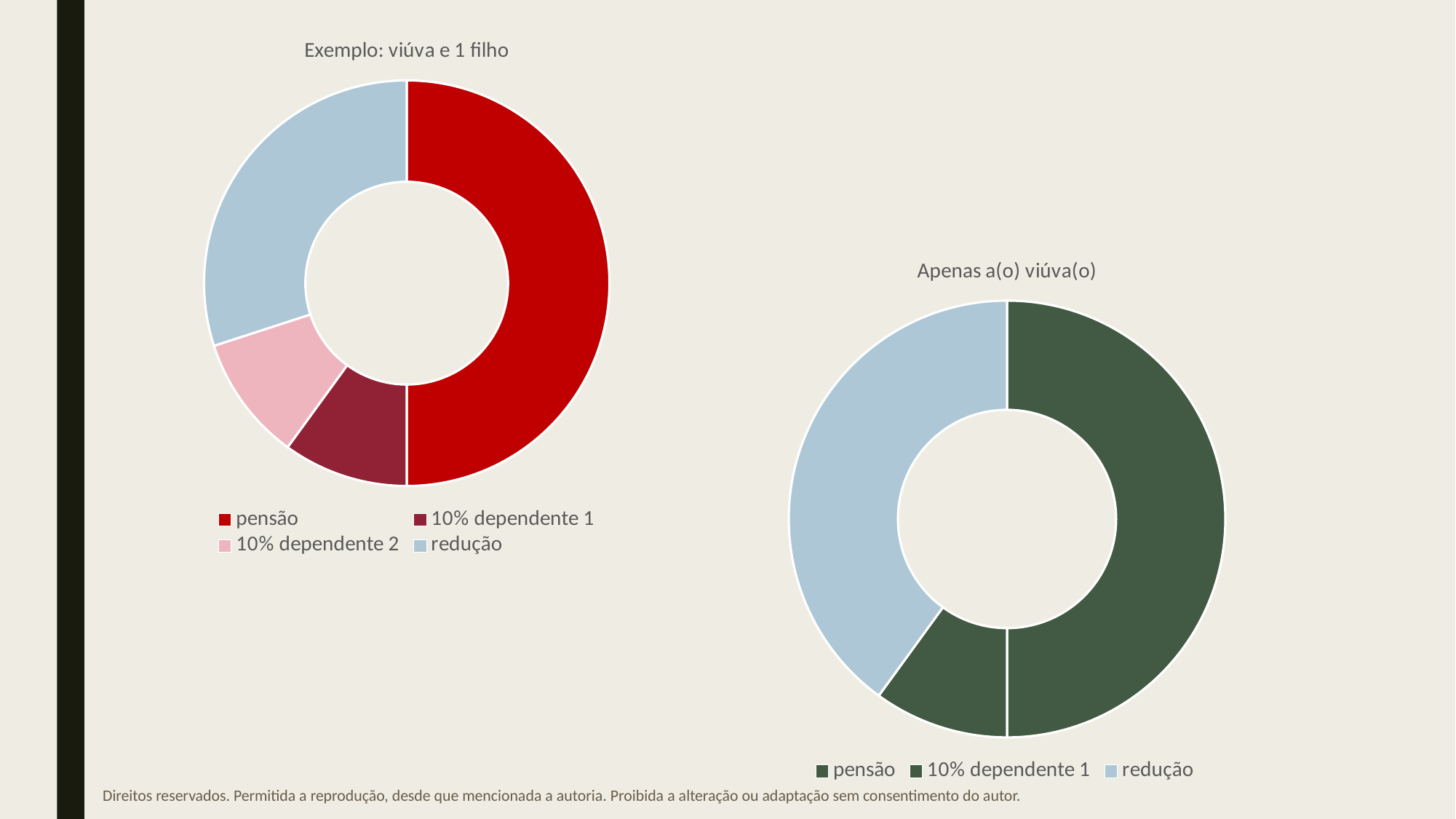
In the chart titled "Apenas a(o) viúva(o)", which slice is the smallest? 10% dependente 1 What is the title of the chart on the right side of the slide? Apenas a(o) viúva(o) In the chart titled "Apenas a(o) viúva(o)", which slice is the largest? pensão In the chart titled "Exemplo: viúva e 1 filho", how many slices does the doughnut have? 4 In the chart titled "Exemplo: viúva e 1 filho", which slice is the largest? pensão In the chart titled "Exemplo: viúva e 1 filho", which slice is larger, pensão or redução? pensão In the chart titled "Exemplo: viúva e 1 filho", how many entries does the legend list? 4 In the chart titled "Apenas a(o) viúva(o)", how many entries does the legend list? 3 What kind of chart is the chart titled "Exemplo: viúva e 1 filho"? Doughnut (pie) chart What kind of chart is the chart titled "Apenas a(o) viúva(o)"? Doughnut (pie) chart In the chart titled "Apenas a(o) viúva(o)", which slice is larger, redução or 10% dependente 1? redução In the chart titled "Apenas a(o) viúva(o)", how many slices does the doughnut have? 3